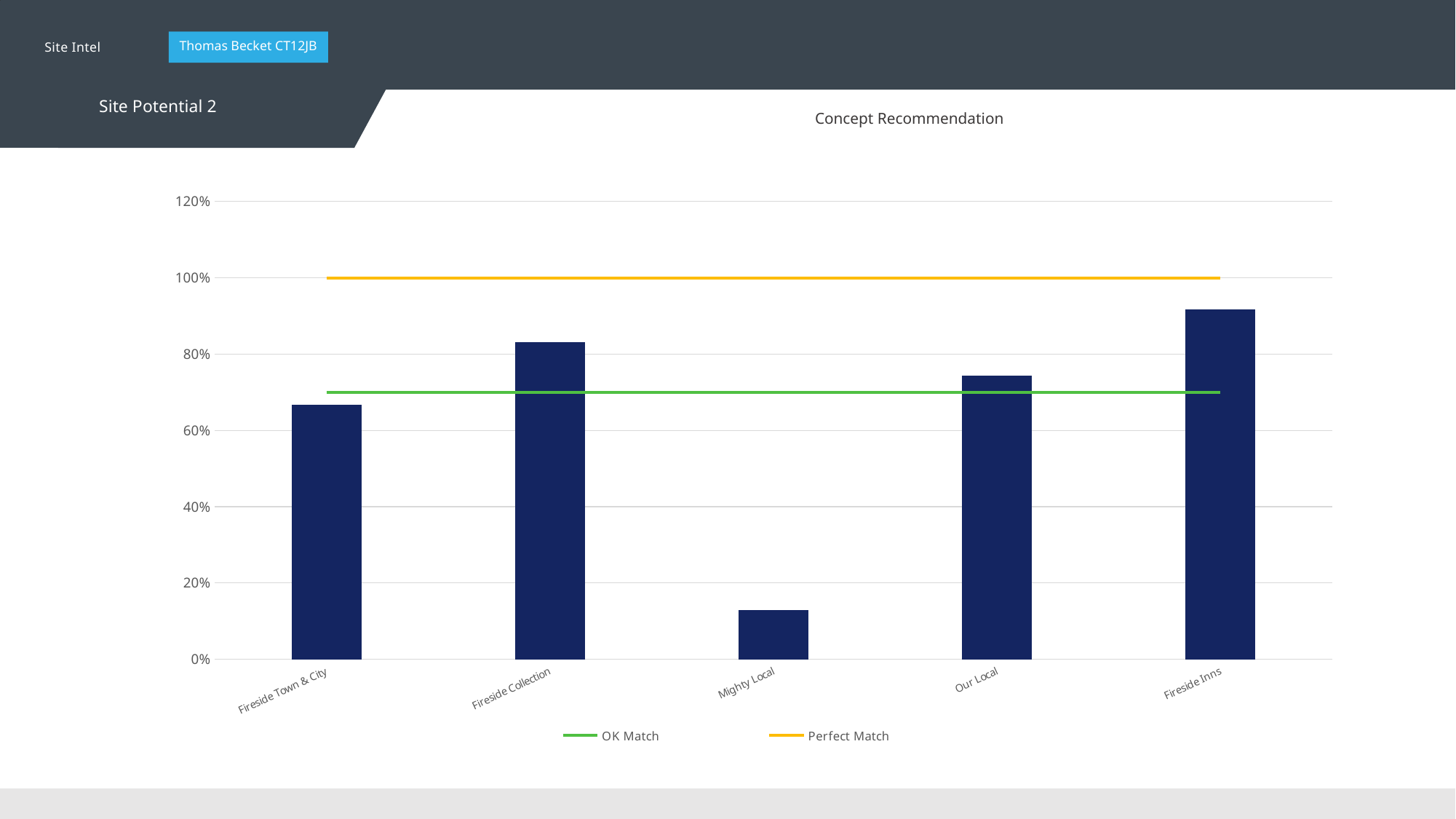
What is the title of the chart? Concept Recommendation What kind of chart is shown on the slide? combination bar and line chart Which category has the lowest bar? Mighty Local Is the value for Mighty Local greater or less than 20%? less At what level does the Perfect Match line sit on the chart? 100% Which is larger, the value for Fireside Town & City or the value for Our Local? Our Local How many categories are shown on the x axis of the chart? 5 How many series does the chart's legend list? 2 Is the value for Fireside Inns greater or less than 80%? greater Which category has the highest bar? Fireside Inns Is the value for Fireside Town & City greater or less than 60%? greater Which is larger, the value for Fireside Collection or the value for Our Local? Fireside Collection